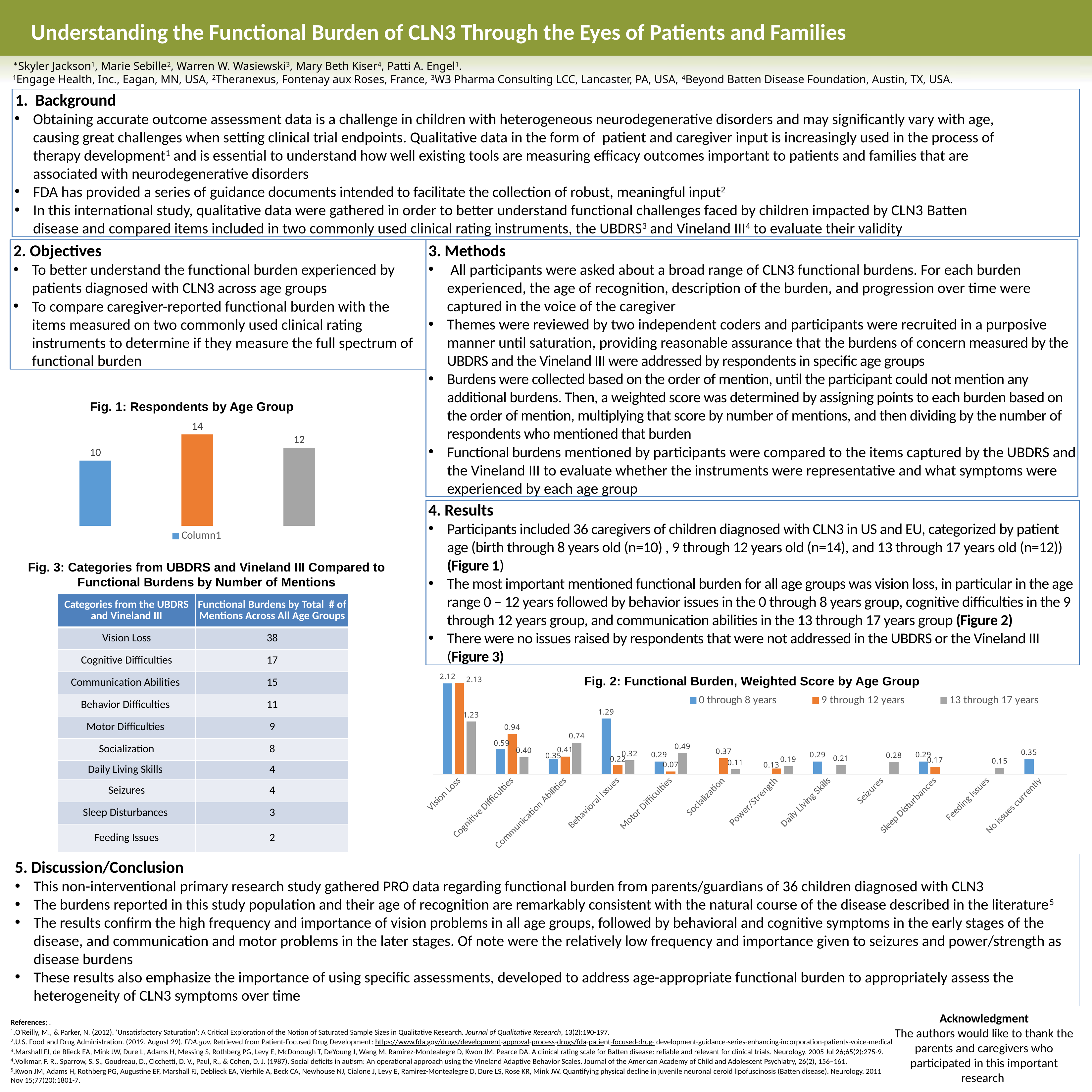
In Fig. 1: Respondents by Age Group, what is the difference between the tallest bar and the shortest bar? 4 In Fig. 1: Respondents by Age Group, how many bars are plotted? 3 In Fig. 1: Respondents by Age Group, what entry does the legend show? Column1 In Fig. 1: Respondents by Age Group, what is the lowest value shown on a bar? 10 In Fig. 2: Functional Burden, Weighted Score by Age Group, how many series does the legend list? 3 In Fig. 2: Functional Burden, Weighted Score by Age Group, what is the weighted score for Vision Loss in the 0 through 8 years group? 2.12 In Fig. 1: Respondents by Age Group, what is the highest value shown on a bar? 14 In Fig. 2: Functional Burden, Weighted Score by Age Group, how many functional burden categories are shown on the x axis? 12 In Fig. 2: Functional Burden, Weighted Score by Age Group, what is the weighted score for Communication Abilities in the 13 through 17 years group? 0.74 In Fig. 2: Functional Burden, Weighted Score by Age Group, what is the difference between the 0 through 8 years score and the 9 through 12 years score for Behavioral Issues? 1.07 In Fig. 2: Functional Burden, Weighted Score by Age Group, which is larger for Cognitive Difficulties: the 9 through 12 years score or the 13 through 17 years score? 9 through 12 years In Fig. 2: Functional Burden, Weighted Score by Age Group, what is the weighted score for Behavioral Issues in the 0 through 8 years group? 1.29